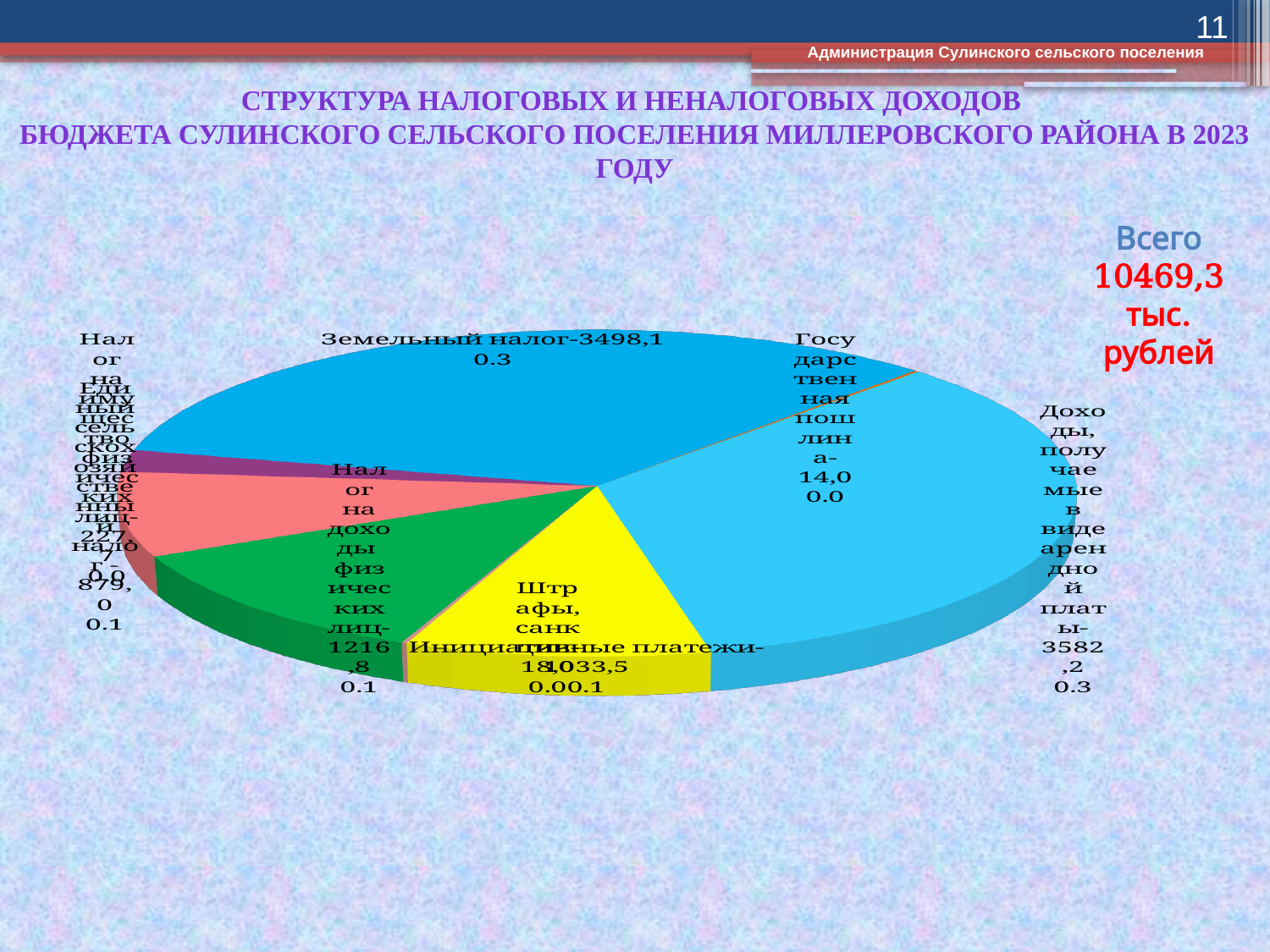
What is the value shown for Налог на доходы физических лиц (personal income tax)? 1216,8 What is the value shown for Инициативные платежи (initiative payments)? 1033,5 What share of the pie is labelled for Земельный налог? 0.3 What is the value shown for Доходы, получаемые в виде арендной платы (rental income)? 3582,2 Which is larger: Земельный налог or Налог на доходы физических лиц? Земельный налог What is the value shown for Земельный налог (land tax)? 3498,1 What kind of chart is shown on the slide? pie chart What is the value shown for Государственная пошлина (state duty)? 14,0 What is the difference between Земельный налог (3498,1) and Налог на доходы физических лиц (1216,8)? 2281,3 What total amount (Всего) is stated on the slide for the revenues shown in the chart? 10469,3 тыс. рублей Which category has the largest value in the pie chart? Доходы, получаемые в виде арендной платы Which category has the smallest value in the pie chart? Государственная пошлина